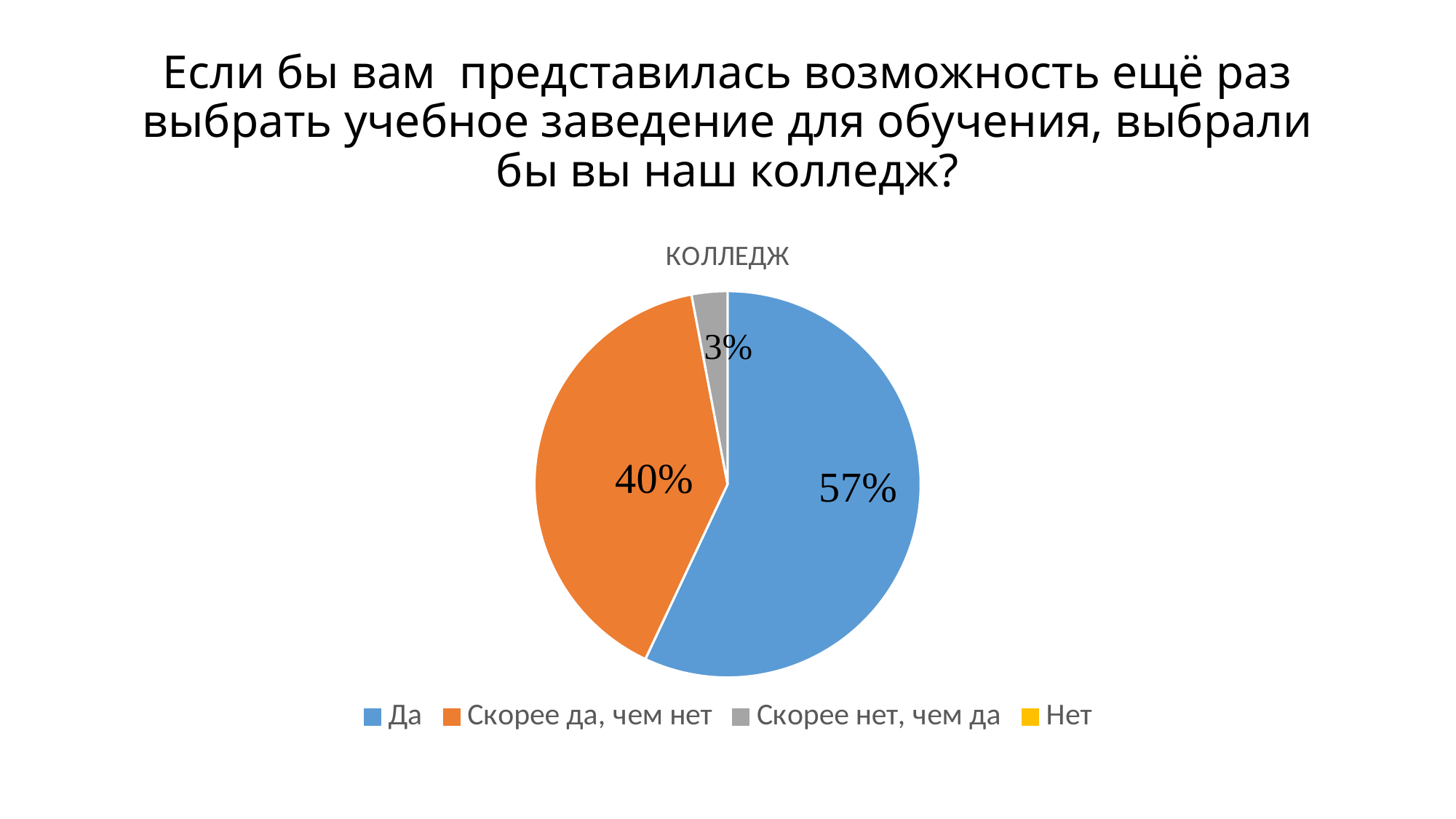
How many entries does the legend list? 4 What is the chart's title? КОЛЛЕДЖ Which category has the largest slice of the pie? Да Which is larger, the share for 'Да' or the share for 'Скорее да, чем нет'? Да What share of the pie is labelled for 'Да'? 57% What colour is the slice for 'Скорее да, чем нет'? orange Which labelled slice is the smallest? Скорее нет, чем да What is the difference between the 'Да' and 'Скорее да, чем нет' shares? 17% What is the combined share of 'Да' and 'Скорее да, чем нет'? 97% What share of the pie is labelled for 'Скорее нет, чем да'? 3% What share of the pie is labelled for 'Скорее да, чем нет'? 40% What type of chart is shown on the slide? pie chart